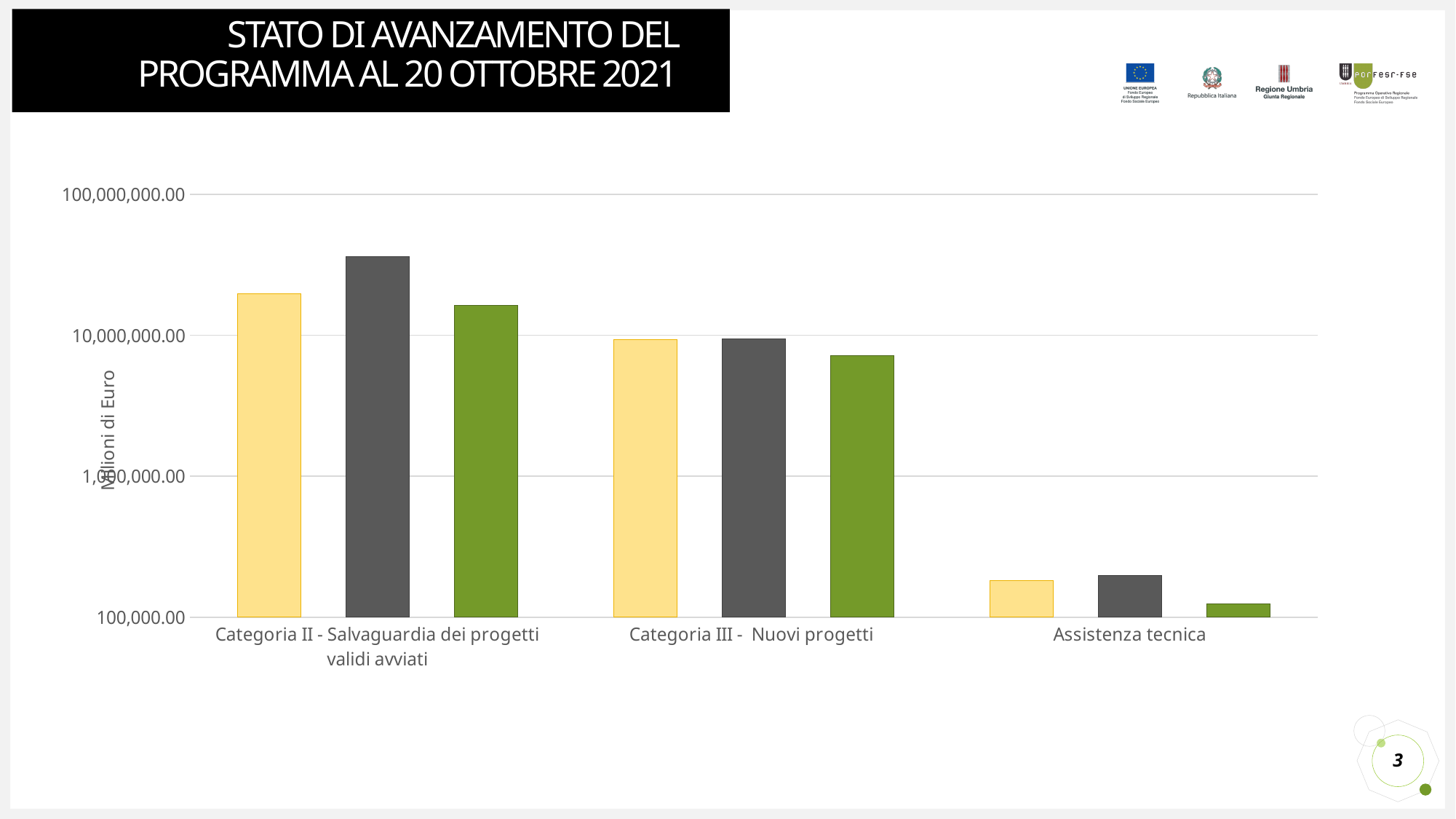
Is the value of the green bar for Categoria III - Nuovi progetti greater or less than 10,000,000.00? less Which category has the tallest bar in the chart? Categoria II - Salvaguardia dei progetti validi avviati What kind of chart is shown on the slide? bar chart Which category has the lowest bars in the chart? Assistenza tecnica Within Assistenza tecnica, which coloured bar is the lowest? green Is the value of the yellow bar for Assistenza tecnica greater or less than 1,000,000.00? less How many categories are shown on the x axis of the chart? 3 Do the bar values rise or fall moving from left to right across the categories? fall Is the value of the dark grey bar for Categoria II - Salvaguardia dei progetti validi avviati greater or less than 10,000,000.00? greater What is the title of the vertical axis of the chart? Milioni di Euro Which is larger: the yellow bar for Categoria II - Salvaguardia dei progetti validi avviati or the yellow bar for Categoria III - Nuovi progetti? Categoria II - Salvaguardia dei progetti validi avviati